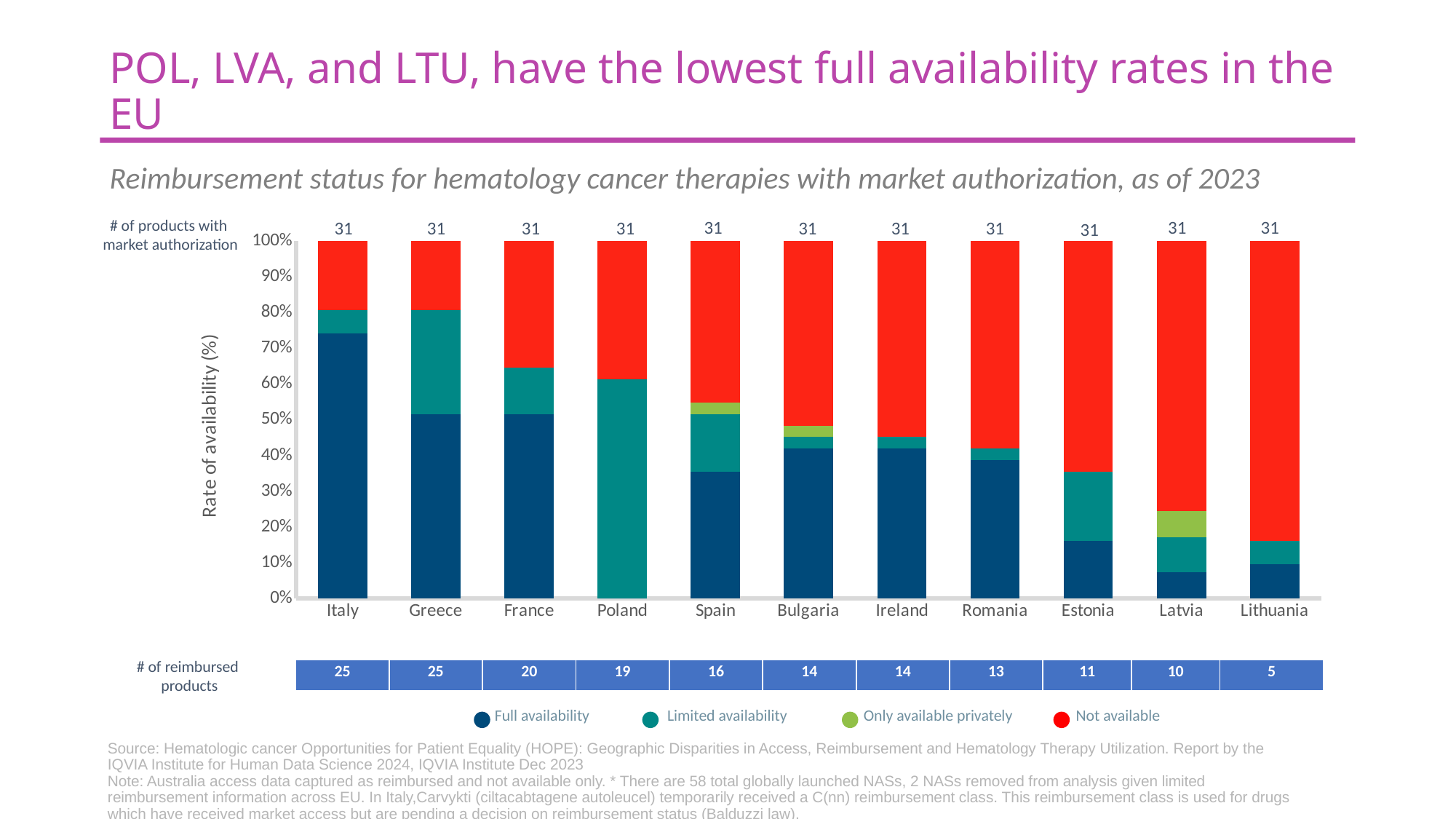
Which country has the lowest number of reimbursed products? Lithuania What colour represents the Not available series in the legend? Red How many products with market authorization are shown above the Poland bar? 31 How many series does the legend list? 4 How many countries are shown on the x axis of the chart? 11 What is the number of reimbursed products for Italy? 25 Which has more reimbursed products, France or Spain? France What is the number of reimbursed products for Lithuania? 5 What kind of chart is shown on the slide? Stacked bar chart What is the difference between the number of reimbursed products for Italy and for Lithuania? 20 Which country has the largest Full availability share? Italy Is the Full availability share for Italy greater or less than 70%? greater